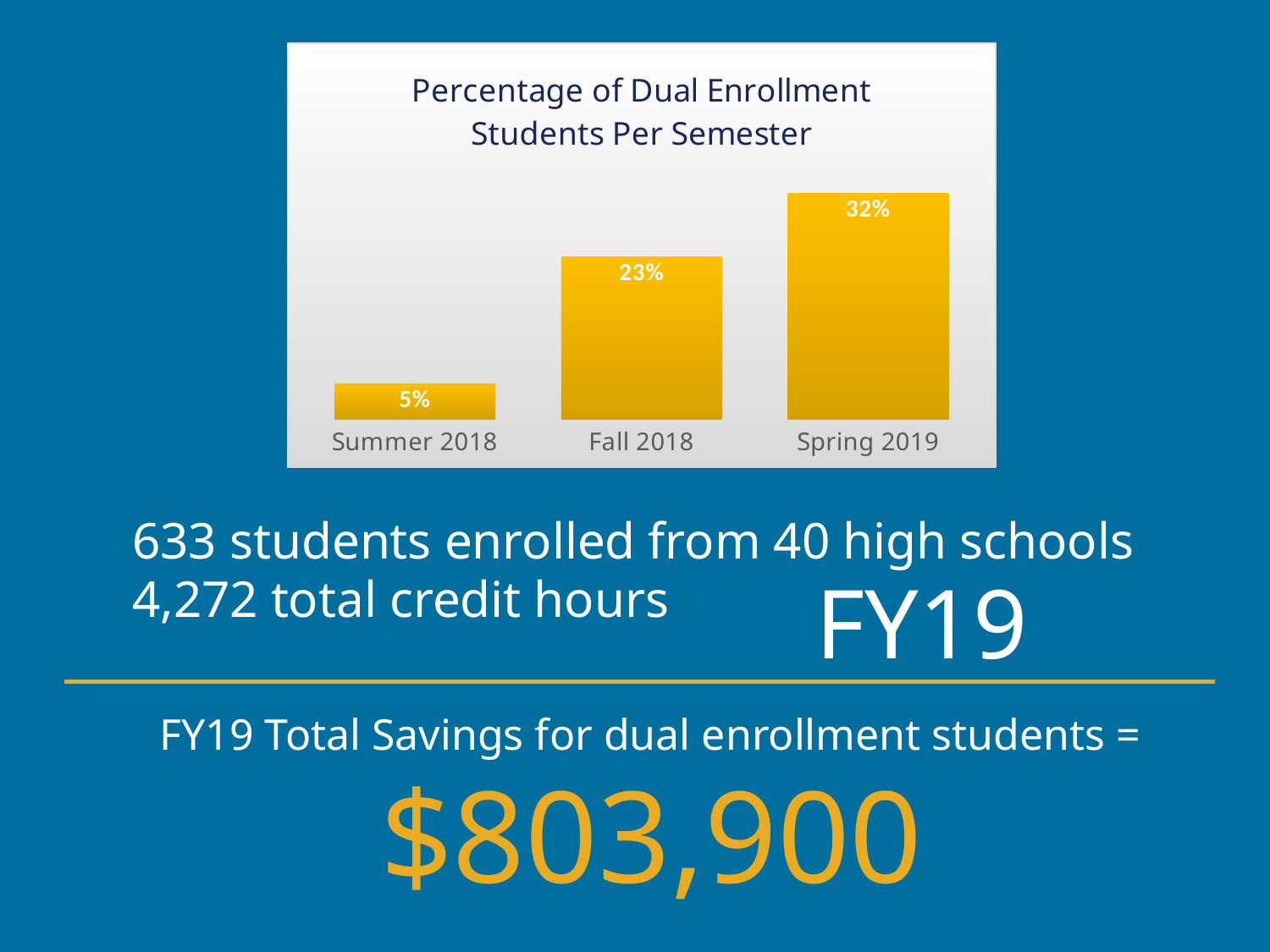
What is the title of the chart? Percentage of Dual Enrollment Students Per Semester What is the value for Spring 2019? 32% What is the difference between the values for Spring 2019 and Fall 2018? 9% Do the values rise or fall from Summer 2018 to Spring 2019? Rise What is the value for Fall 2018? 23% What kind of chart is shown on the slide? Bar chart Which is larger, the value for Fall 2018 or the value for Summer 2018? Fall 2018 How many semesters are shown in the chart? 3 Which semester has the lowest percentage of dual enrollment students? Summer 2018 Which semester has the highest percentage of dual enrollment students? Spring 2019 What is the value for Summer 2018? 5% What is the difference between the values for Fall 2018 and Summer 2018? 18%